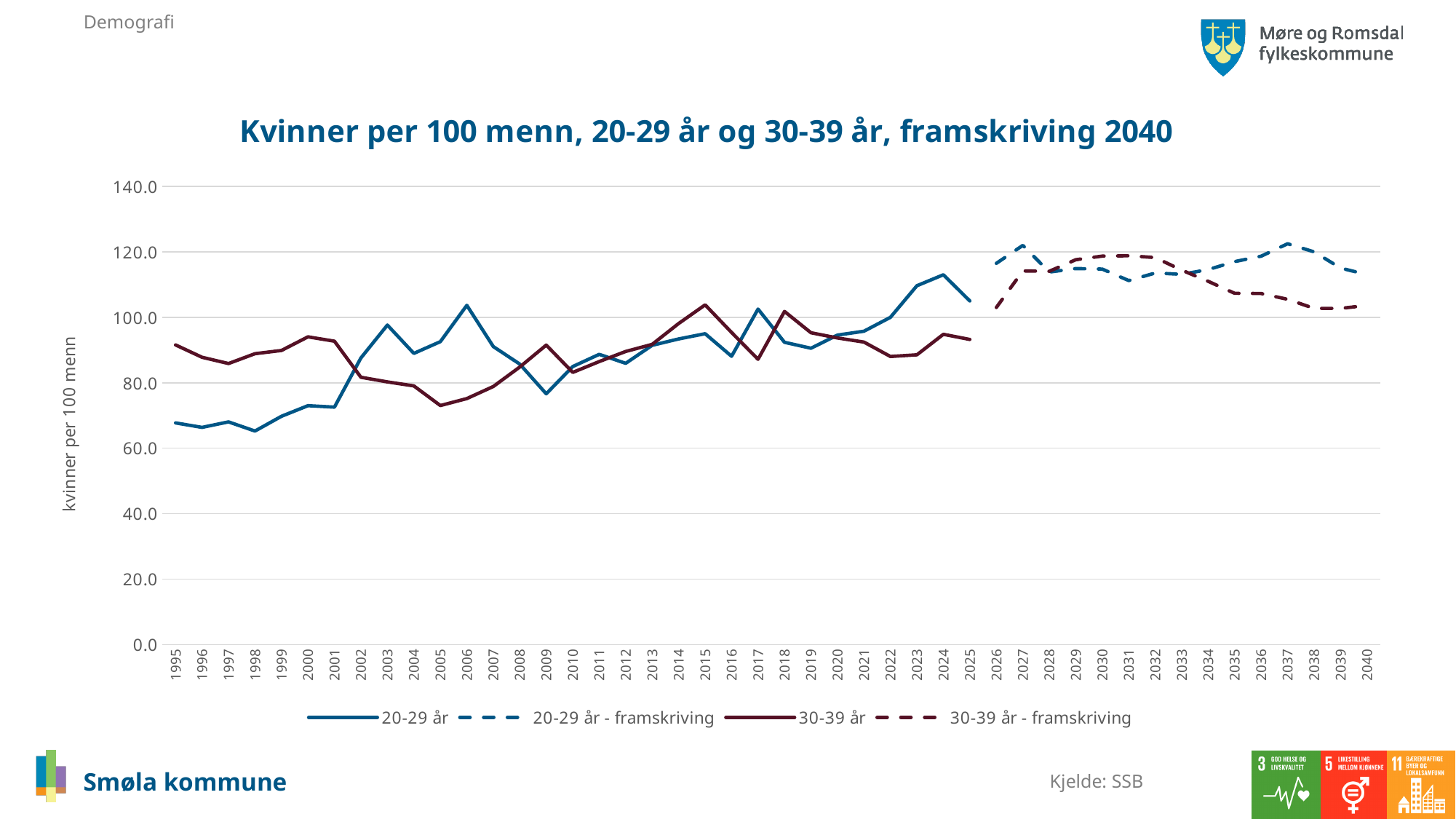
How many series does the legend list? 4 Is the value for 30-39 år - framskriving in 2040 greater or less than 120? less In which year does the 20-29 år series (solid line) reach its highest value? 2024 Is the value for 20-29 år in 2006 greater or less than 100? greater Is the value for 20-29 år - framskriving in 2037 greater or less than 120? greater What kind of chart is shown on the slide? line chart How many years are shown along the x axis? 46 What is the label on the vertical axis? kvinner per 100 menn In 1995, which series has the higher value, 20-29 år or 30-39 år? 30-39 år What is the title of the chart? Kvinner per 100 menn, 20-29 år og 30-39 år, framskriving 2040